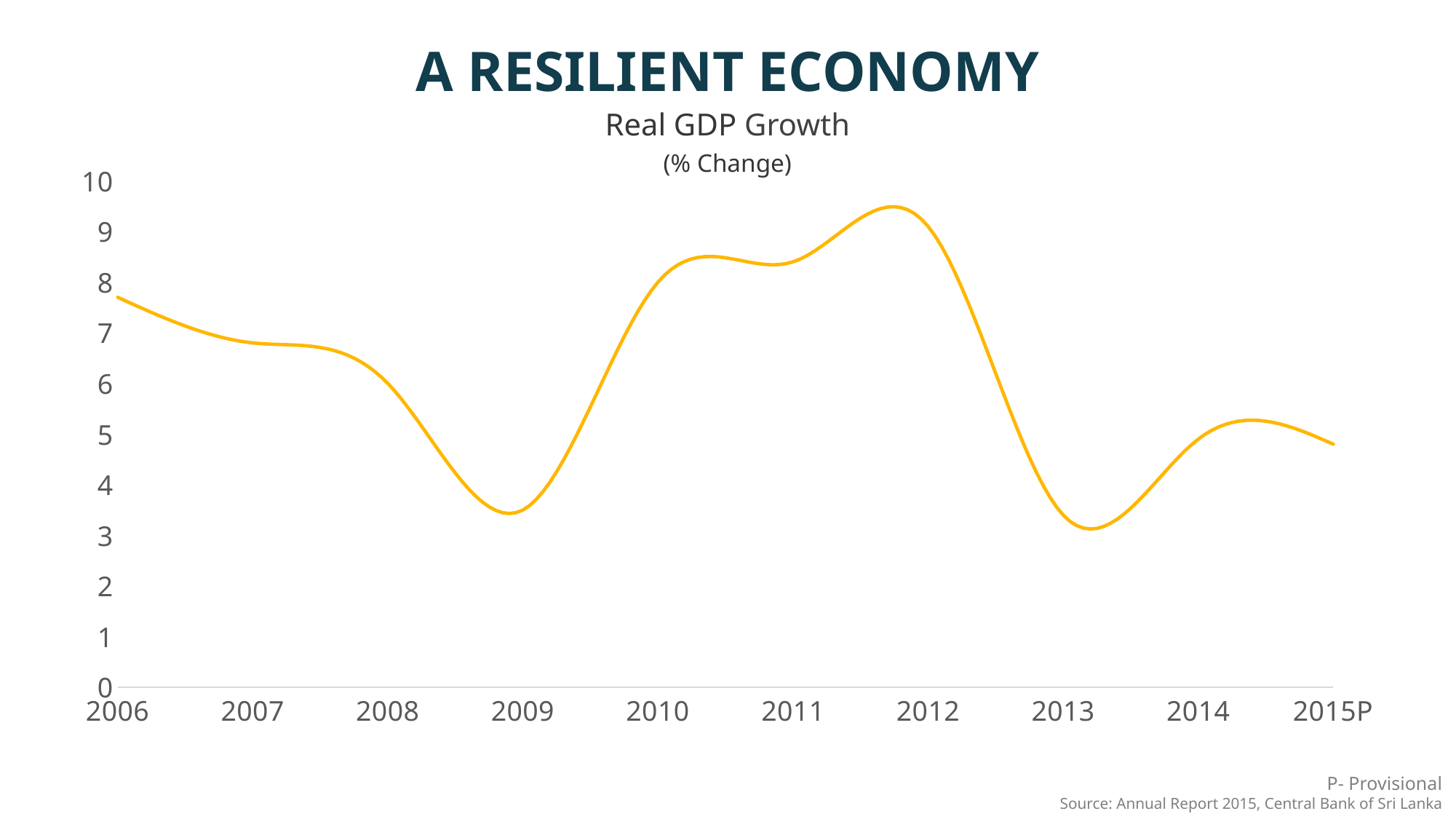
Is the real GDP growth value for 2009 greater or less than 4? less Does real GDP growth rise or fall from 2009 to 2012? rise What unit is shown in the chart subtitle? % Change How many years are plotted along the x axis? 10 What kind of chart is shown on the slide? line chart Is the real GDP growth value for 2006 greater or less than 7? greater Which year has the larger real GDP growth, 2012 or 2013? 2012 Is the real GDP growth value for 2013 greater or less than 4? less Does real GDP growth rise or fall from 2006 to 2009? fall Which year has the highest real GDP growth? 2012